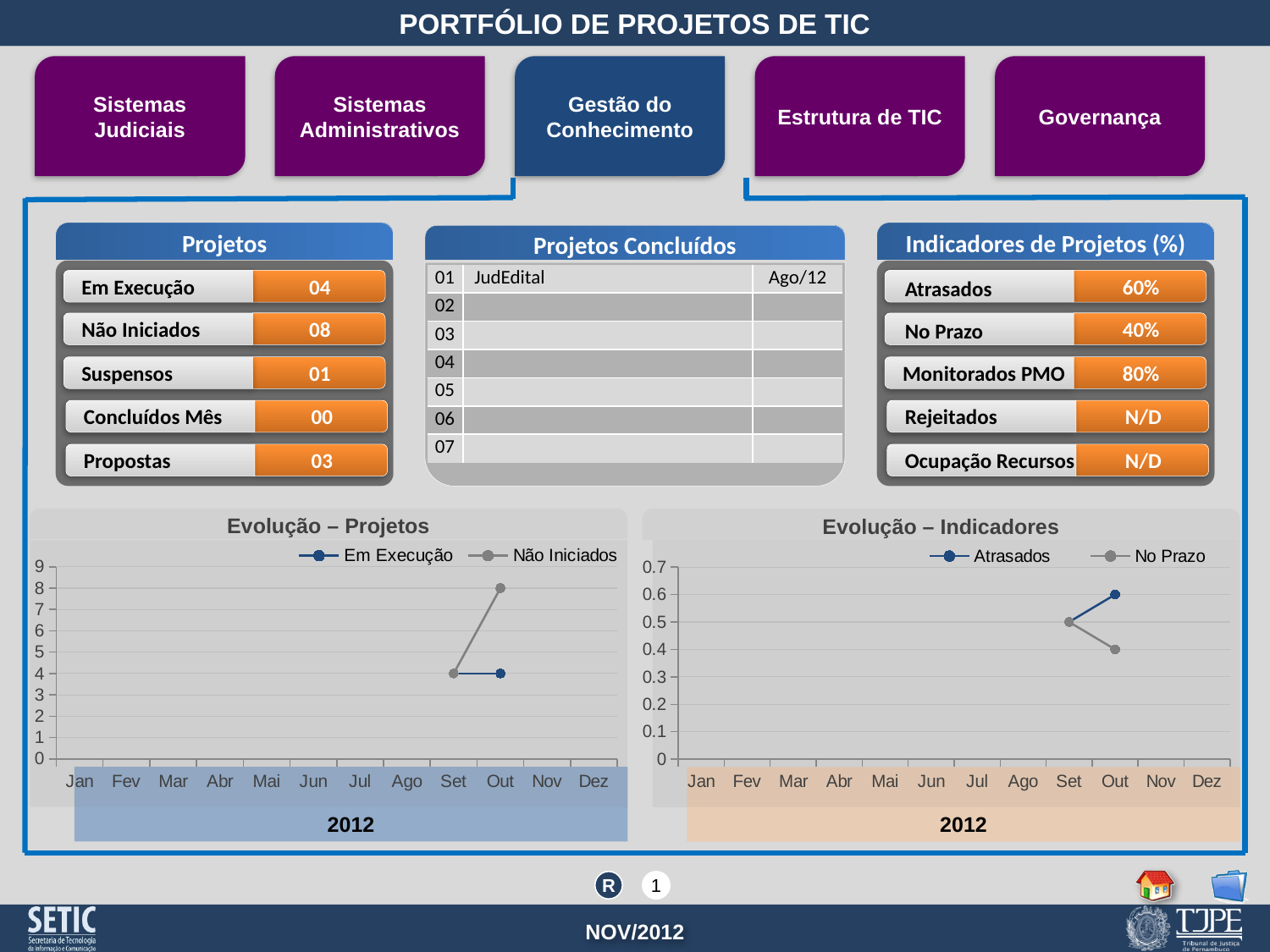
In the 'Evolução – Indicadores' chart, which two series are listed in the legend? Atrasados and No Prazo In the 'Evolução – Projetos' chart, does the Não Iniciados series rise or fall from Set to Out? rise In the 'Evolução – Projetos' chart, what is the value for Não Iniciados in Out? 8 In the 'Evolução – Indicadores' chart, what is the value for Atrasados in Out? 0.6 In the 'Evolução – Indicadores' chart, what is the value for No Prazo in Out? 0.4 In the 'Evolução – Projetos' chart, how many months are shown on the x axis? 12 In the 'Evolução – Projetos' chart, what kind of chart is it? line chart In the 'Evolução – Indicadores' chart, does the No Prazo series rise or fall from Set to Out? fall In the 'Evolução – Projetos' chart, what is the value for Em Execução in Out? 4 In the 'Evolução – Projetos' chart, how many series does the legend list? 2 In the 'Evolução – Projetos' chart, which series is higher in Out, Em Execução or Não Iniciados? Não Iniciados In the 'Evolução – Projetos' chart, what is the difference between Não Iniciados and Em Execução in Out? 4